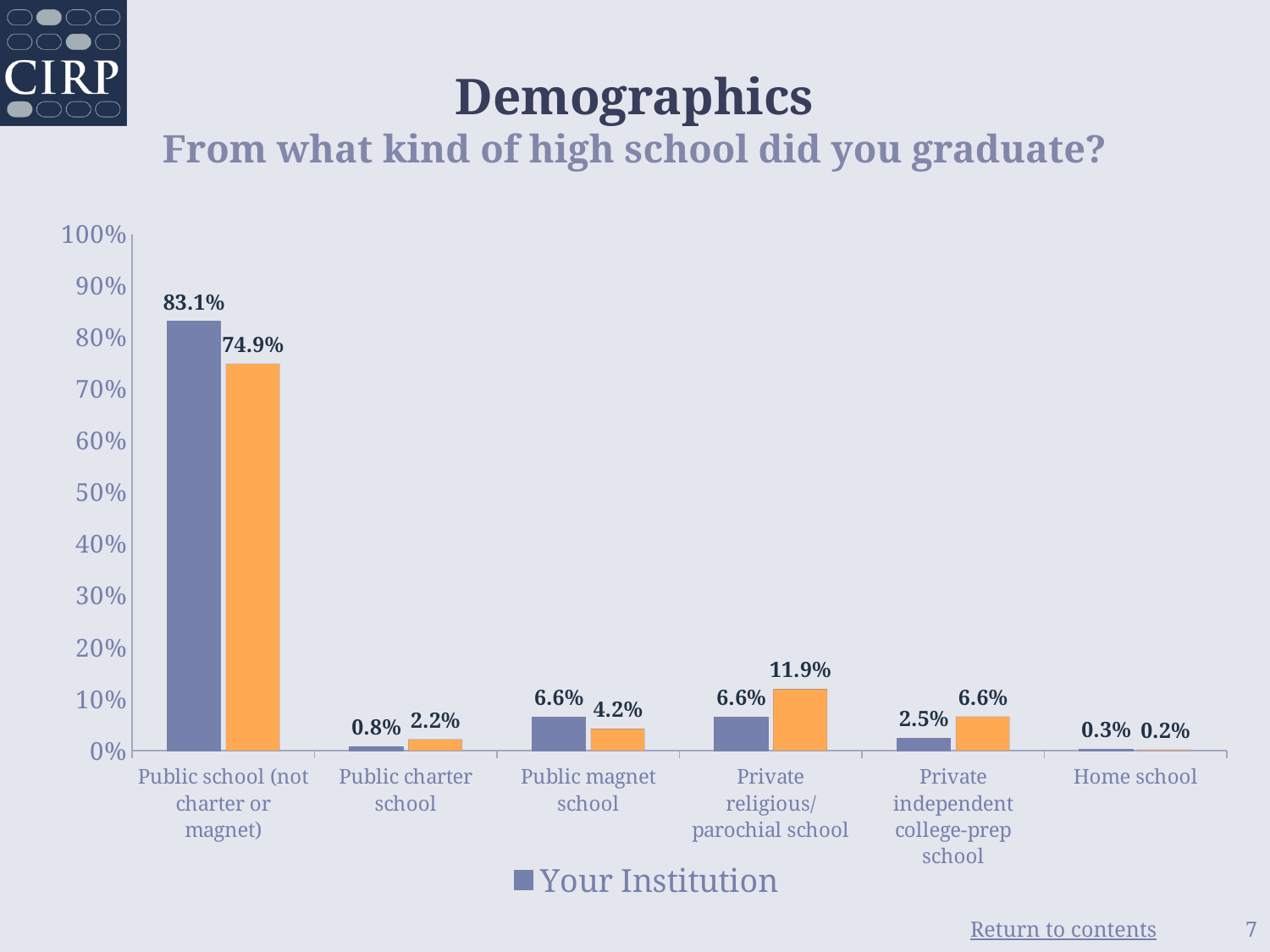
What is the value for Your Institution for Home school? 0.3% Which category has the lowest value for Your Institution? Home school What is the value for Your Institution for Public charter school? 0.8% Is the Your Institution value for Public school (not charter or magnet) greater or less than 80%? greater For Your Institution, which is larger: Private independent college-prep school or Public charter school? Private independent college-prep school What is the difference between the Your Institution values for Public school (not charter or magnet) and Public magnet school? 76.5% Which category has the highest value for Your Institution? Public school (not charter or magnet) What is the value for Your Institution for Private independent college-prep school? 2.5% What is the value for Your Institution for Public school (not charter or magnet)? 83.1% How many categories are shown on the x axis? 6 What kind of chart is shown on the slide? Bar chart How many series does the legend list? 1